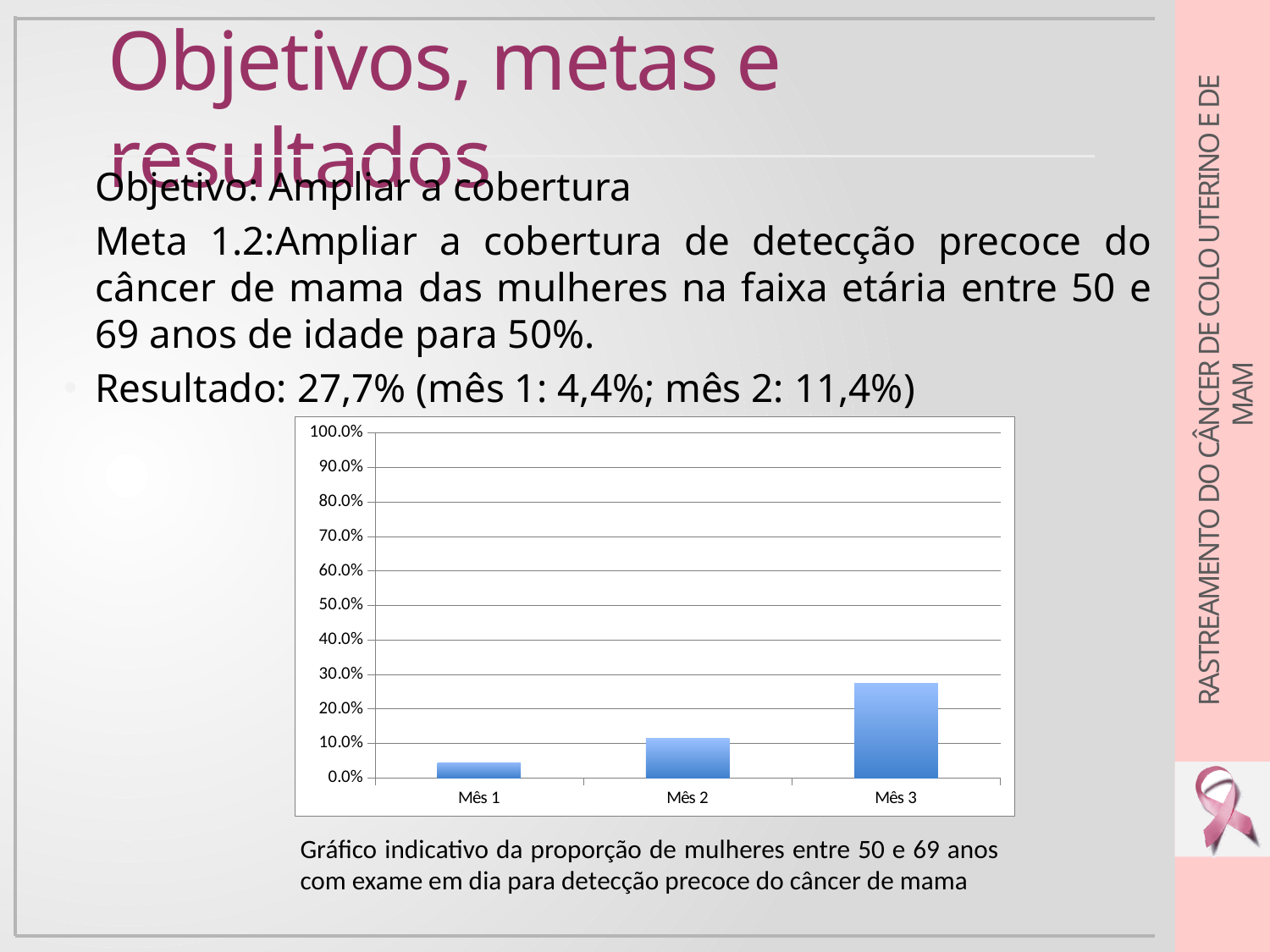
Do the values rise or fall from Mês 1 to Mês 3? rise How many categories are plotted on the x axis of the chart? 3 Is the value for Mês 1 greater or less than 10.0%? less Is the value for Mês 3 greater or less than 20.0%? greater What is the maximum value shown on the y axis of the chart? 100.0% Is the value for Mês 3 greater or less than 30.0%? less Which month has the highest bar in the chart? Mês 3 Which month has the lowest bar in the chart? Mês 1 Which is larger, the value for Mês 2 or the value for Mês 3? Mês 3 According to the slide text, what is the value for mês 1? 4,4% What kind of chart is shown on the slide? bar chart